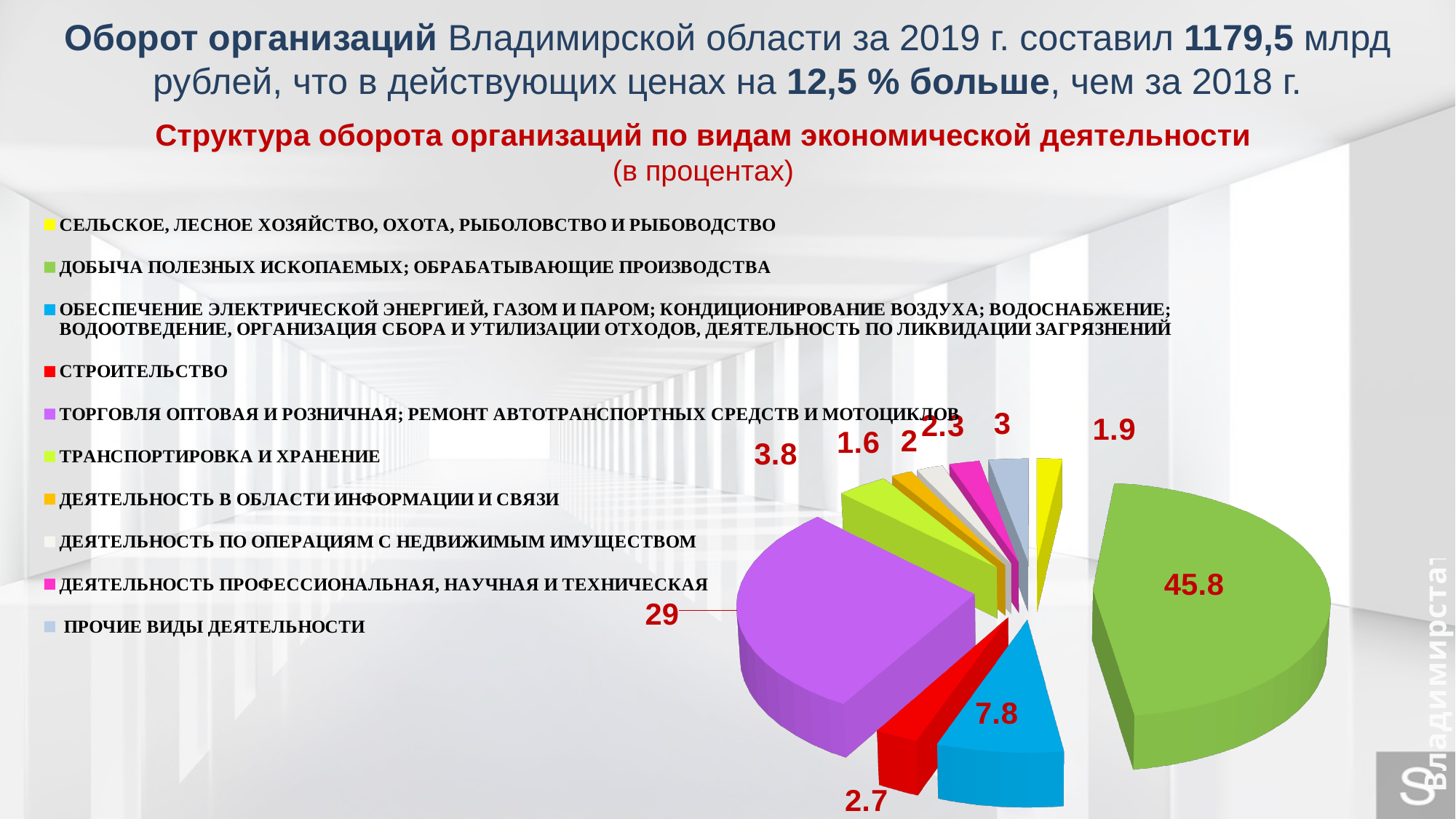
What is the title of the chart? Структура оборота организаций по видам экономической деятельности (в процентах) What share of turnover does "Торговля оптовая и розничная; ремонт автотранспортных средств и мотоциклов" have? 29 Which is larger: the share for "Строительство" or the share for "Деятельность профессиональная, научная и техническая"? Строительство What kind of chart is shown on the slide? pie chart What is the value for "Строительство"? 2.7 Which type of economic activity has the largest share of turnover? Добыча полезных ископаемых; обрабатывающие производства Which type of economic activity has the smallest share of turnover? Деятельность в области информации и связи What is the difference between the shares of "Добыча полезных ископаемых; обрабатывающие производства" and "Торговля оптовая и розничная; ремонт автотранспортных средств и мотоциклов"? 16.8 What share of turnover does "Добыча полезных ископаемых; обрабатывающие производства" have? 45.8 How many types of economic activity are shown in the pie chart? 10 What is the value for "Транспортировка и хранение"? 3.8 What is the value for "Прочие виды деятельности"? 3